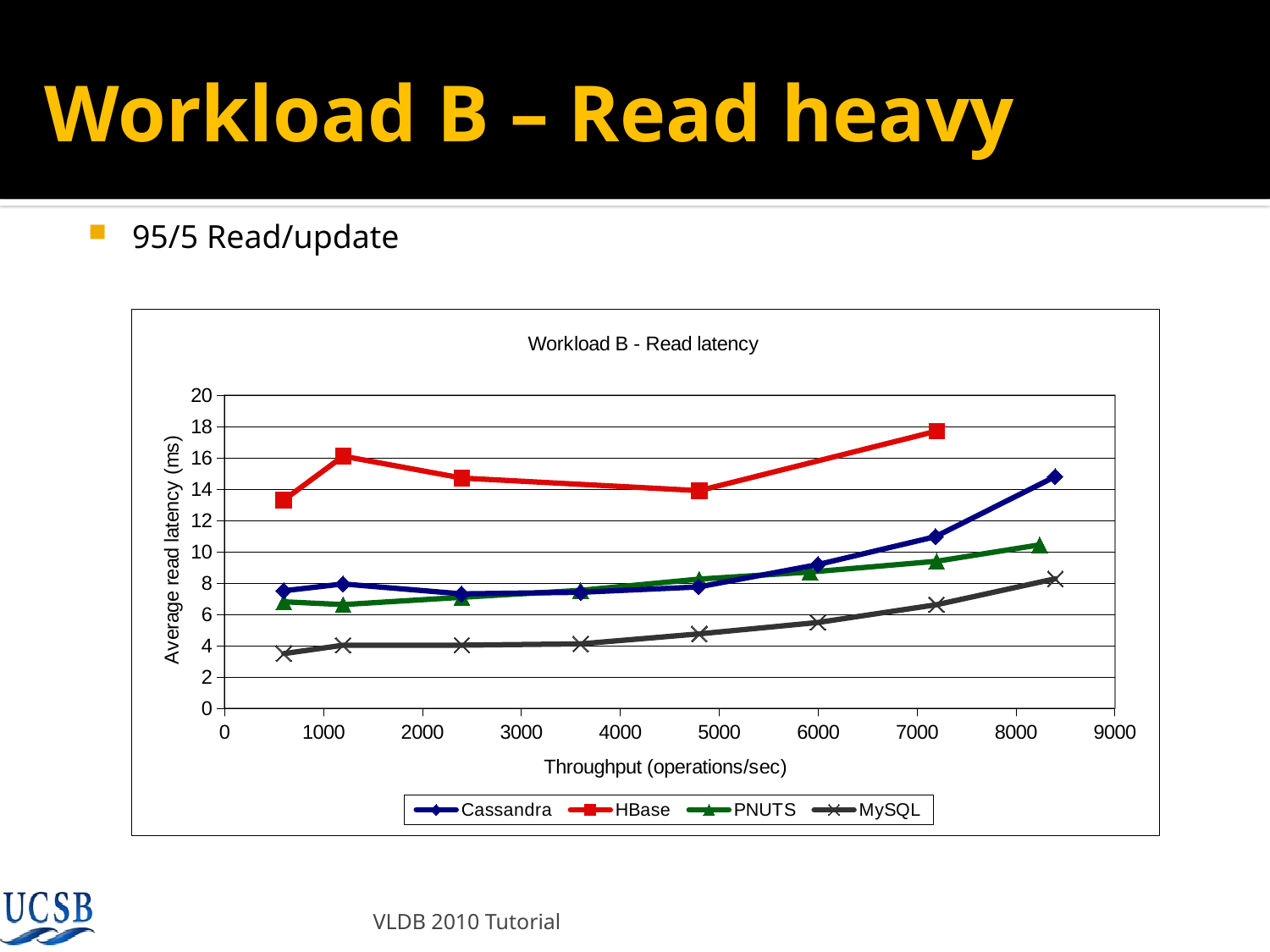
What is the title of the chart? Workload B - Read latency Is the MySQL read latency at its leftmost point (around 600 operations/sec) greater or less than 4 ms? less At around 7200 operations/sec, which has the higher read latency, Cassandra or PNUTS? Cassandra What is the label of the x axis of the chart? Throughput (operations/sec) Is the HBase read latency at its leftmost point (around 600 operations/sec) greater or less than 12 ms? greater How many data points are plotted for the HBase series? 5 What kind of chart is shown on the slide? line chart Does the MySQL read latency rise or fall as throughput increases? rises Which series has the lowest average read latency across the chart? MySQL How many series does the legend of the chart list? 4 Is the HBase read latency at its rightmost point (around 7200 operations/sec) greater or less than 16 ms? greater Which series has the highest average read latency across the chart? HBase